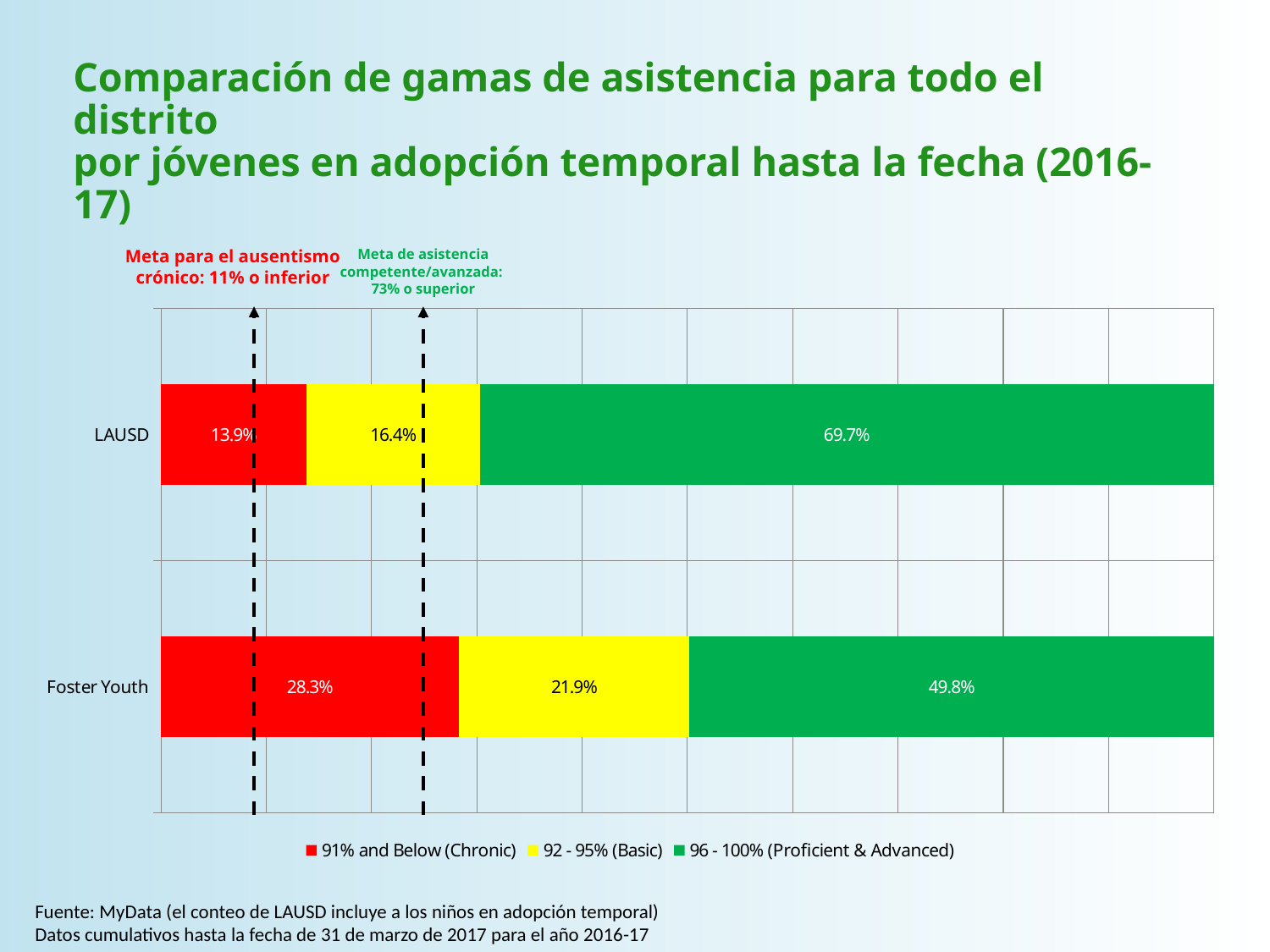
What is the difference between the LAUSD and Foster Youth values in the 96 - 100% (Proficient & Advanced) range? 19.9 percentage points How many groups (categories) are shown on the chart? 2 What percentage of Foster Youth fall in the 96 - 100% (Proficient & Advanced) attendance range? 49.8% How many series does the legend list? 3 What is the value for Foster Youth in the 92 - 95% (Basic) range? 21.9% Which group has the higher share in the 91% and Below (Chronic) range, LAUSD or Foster Youth? Foster Youth What is the value for LAUSD in the 96 - 100% (Proficient & Advanced) range? 69.7% Which group has the higher share in the 96 - 100% (Proficient & Advanced) range, LAUSD or Foster Youth? LAUSD What percentage of LAUSD students fall in the 91% and Below (Chronic) attendance range? 13.9% What is the difference between the Foster Youth and LAUSD values in the 91% and Below (Chronic) range? 14.4 percentage points What colour represents the 92 - 95% (Basic) attendance range? Yellow What kind of chart is shown on the slide? Stacked bar chart